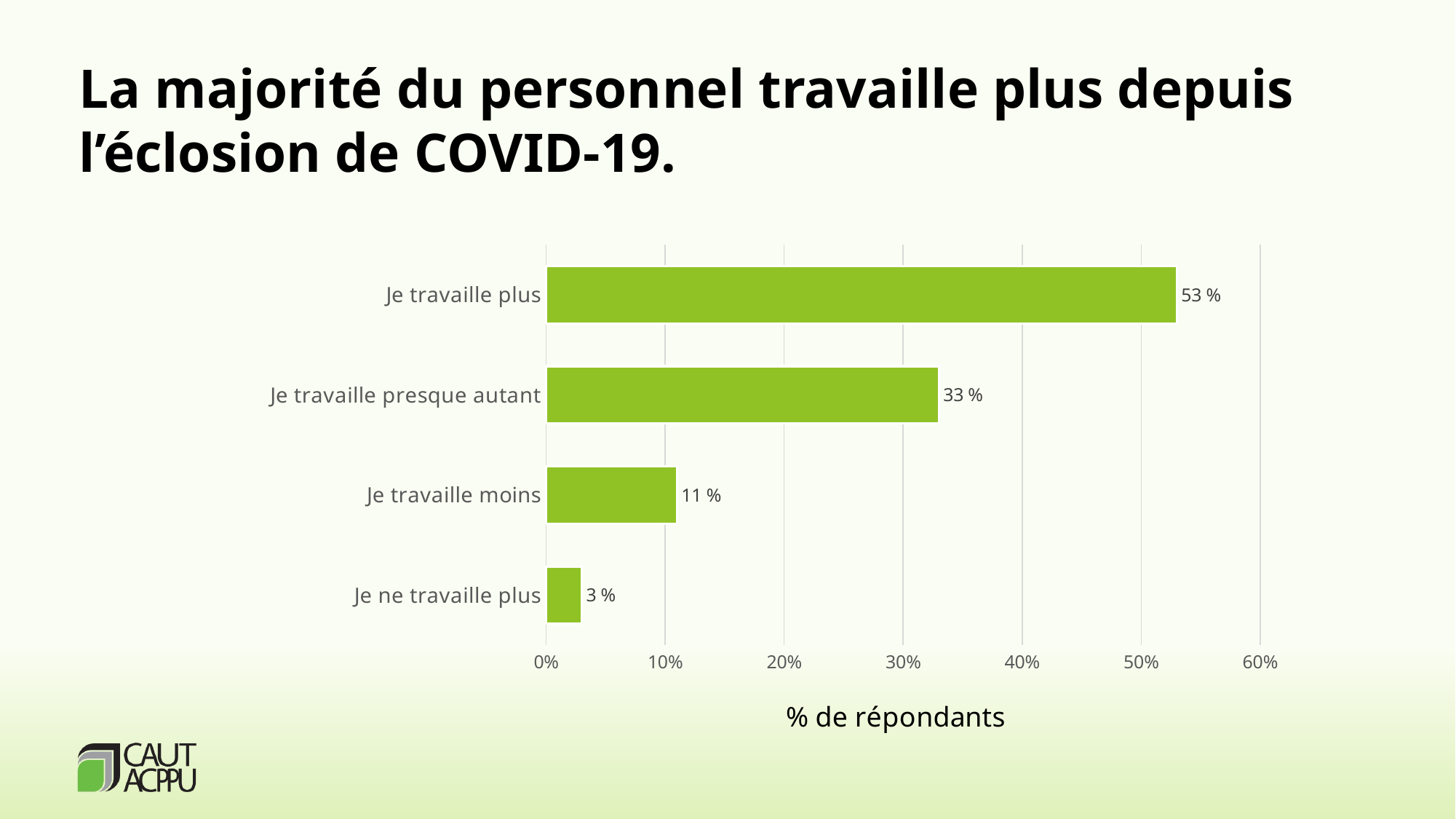
What is the value for "Je ne travaille plus"? 3 % What is the value for "Je travaille presque autant"? 33 % Which is larger, the value for "Je travaille moins" or the value for "Je ne travaille plus"? Je travaille moins Which category has the lowest value? Je ne travaille plus What is the value for "Je travaille moins"? 11 % What is the value for "Je travaille plus"? 53 % Which category has the highest value? Je travaille plus How many categories are shown in the chart? 4 What is the label of the horizontal axis? % de répondants Is the value for "Je travaille presque autant" greater or less than 30%? greater What is the difference between the values for "Je travaille plus" and "Je travaille presque autant"? 20 % What kind of chart is shown on the slide? bar chart